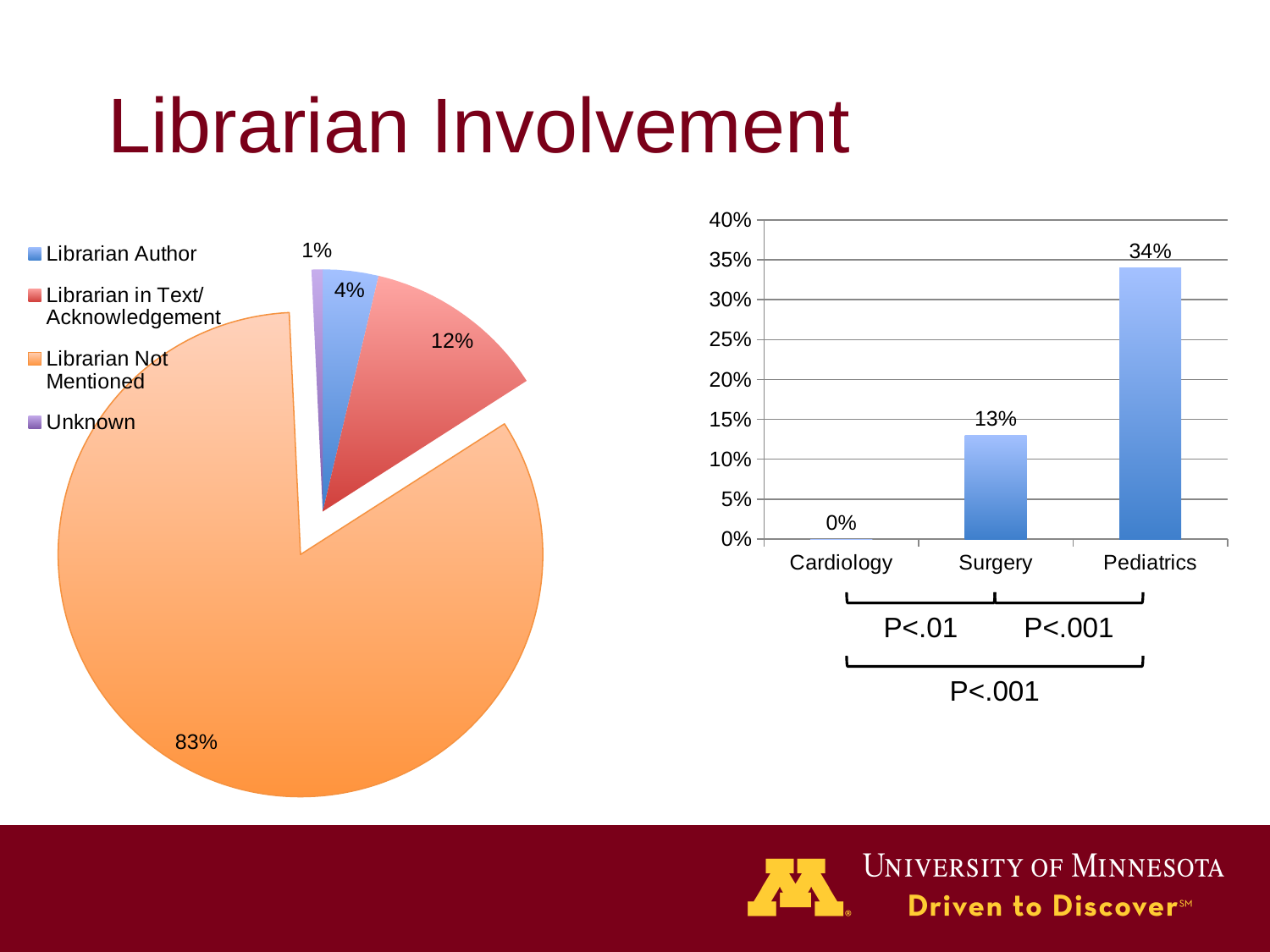
In the pie chart on the left, what share is labelled for Librarian Not Mentioned? 83% In the pie chart on the left, what colour is the Librarian Not Mentioned slice? Orange In the pie chart on the left, what share is labelled for Librarian Author? 4% In the bar chart on the right, which category has the highest value? Pediatrics In the bar chart on the right, what is the value for Pediatrics? 34% In the bar chart on the right, what is the difference between the values for Pediatrics and Surgery? 21% In the pie chart on the left, how many categories does the legend list? 4 In the bar chart on the right, what is the value for Cardiology? 0% What kind of chart is shown on the right side of the slide? Bar chart In the pie chart on the left, which category has the smallest slice? Unknown In the pie chart on the left, what share is labelled for Librarian in Text/Acknowledgement? 12% In the bar chart on the right, what is the value for Surgery? 13%